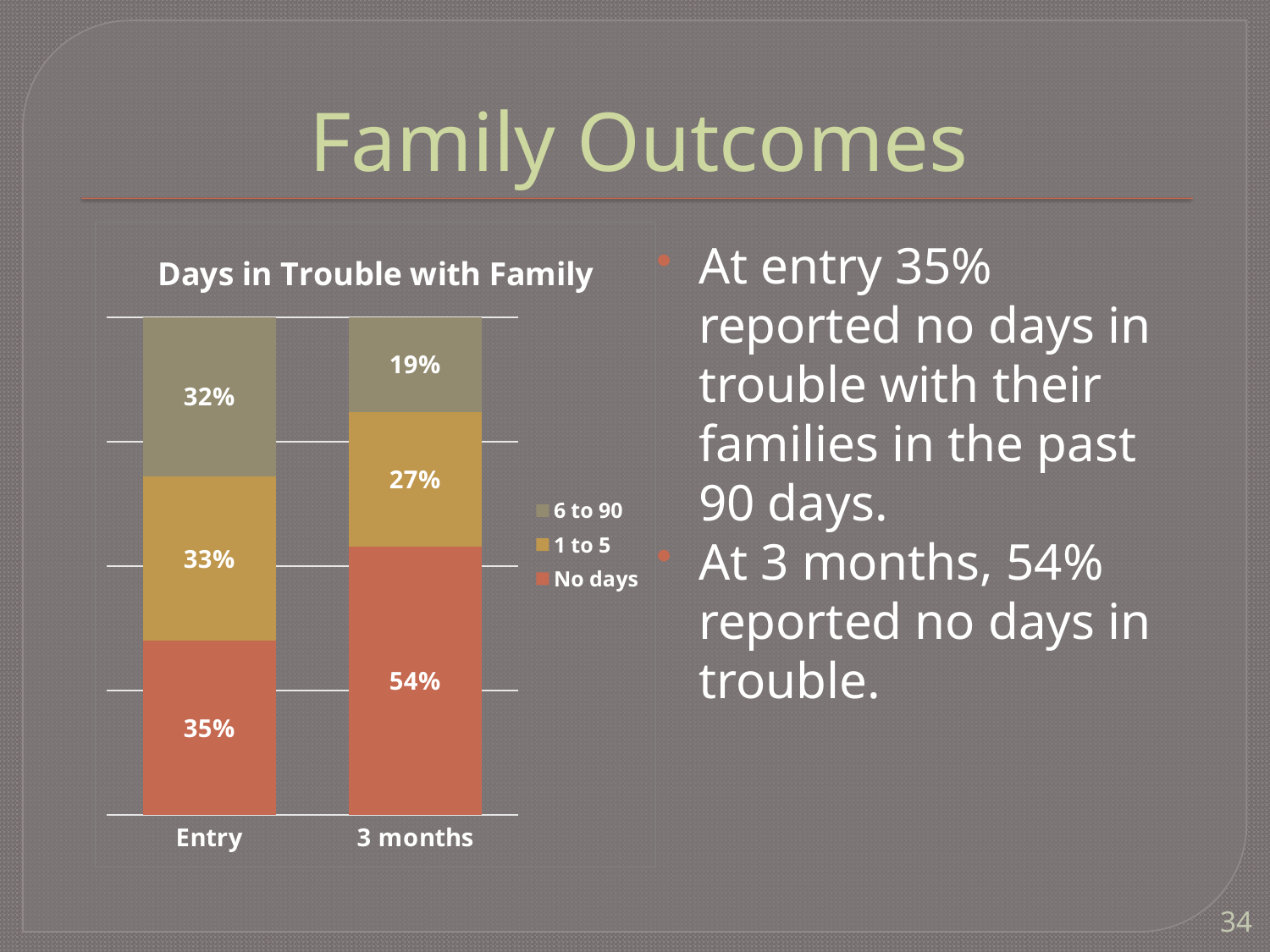
What is the difference between the 'No days' value at 3 months and at Entry? 19% What is the total of the stacked bar for Entry? 100% What type of chart is shown? Stacked bar chart What is the chart's title? Days in Trouble with Family What is the value for '6 to 90' days at 3 months? 19% Does the 'No days' share rise or fall from Entry to 3 months? Rise How many series does the legend list? 3 Which is larger: the '6 to 90' value at Entry or at 3 months? Entry What percentage reported no days in trouble with family at Entry? 35% How many categories are shown on the x axis? 2 What is the value for '1 to 5' days at Entry? 33% What percentage reported no days in trouble with family at 3 months? 54%